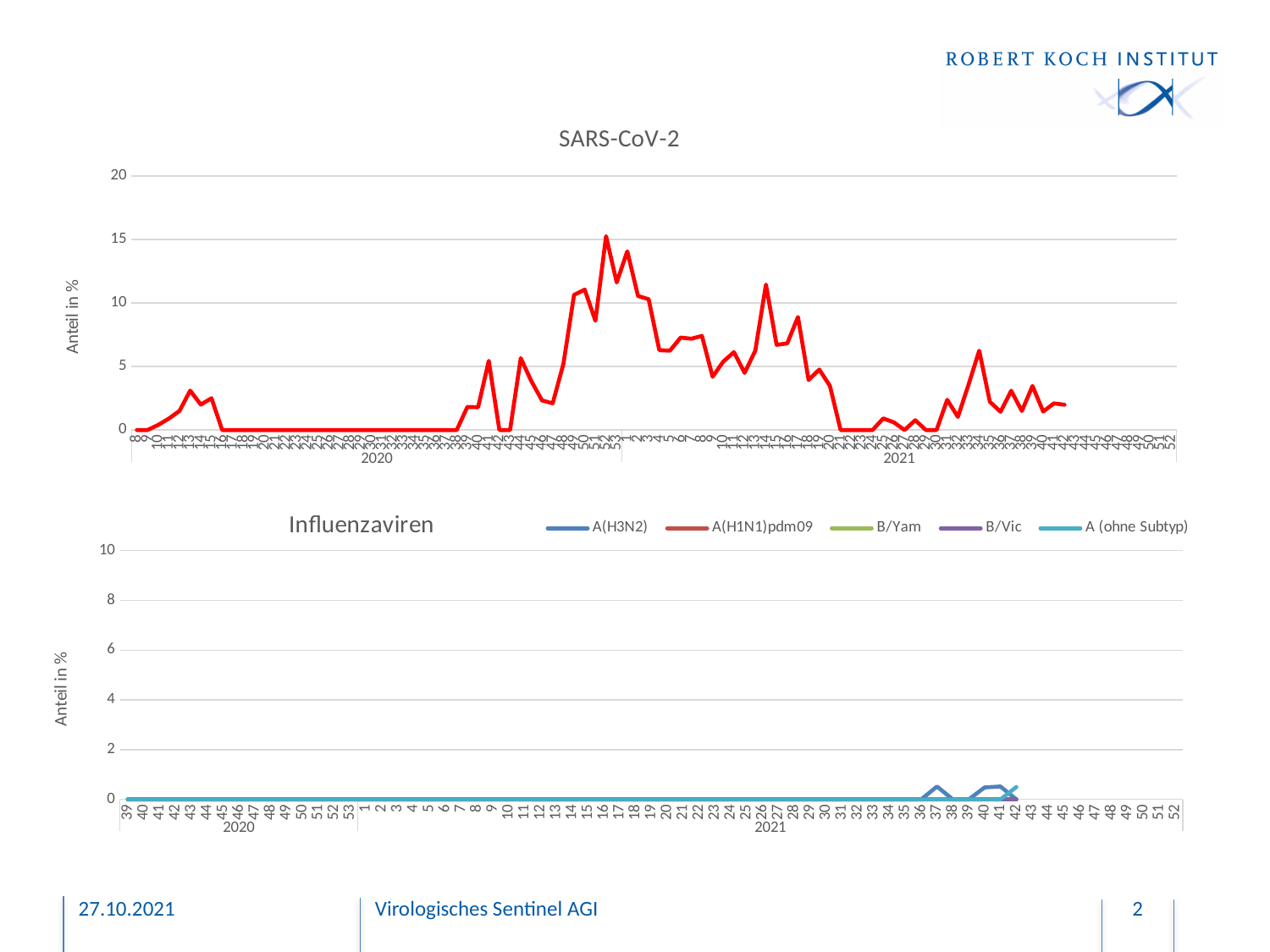
What kind of chart is the bottom chart titled Influenzaviren? line chart In the SARS-CoV-2 chart, is the value at week 1 of 2021 greater or less than 10? greater In the SARS-CoV-2 chart, does the line rise or fall between week 20 of 2021 and week 24 of 2021? fall What kind of chart is the top chart titled SARS-CoV-2? line chart In the SARS-CoV-2 chart, is the highest value of the line greater or less than 10? greater What is the title of the top chart? SARS-CoV-2 In the Influenzaviren chart, is the highest plotted value greater or less than 2? less How many series does the legend of the Influenzaviren chart list? 5 What is the y-axis label of the Influenzaviren chart? Anteil in %